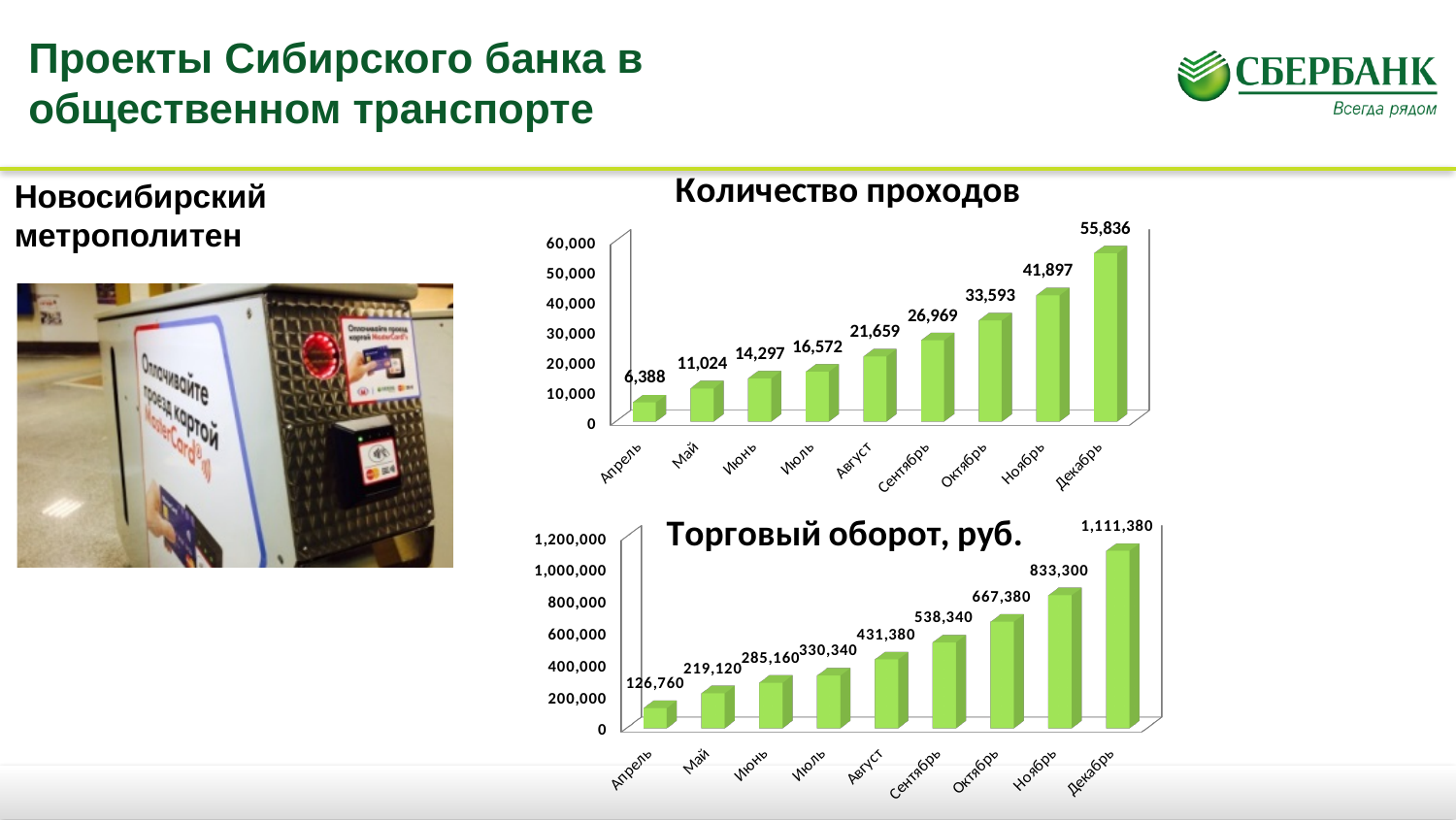
In the "Торговый оборот, руб." chart, what is the difference between the values for Ноябрь and Октябрь? 165,920 What kind of chart is the "Торговый оборот, руб." chart? bar chart In the "Торговый оборот, руб." chart, what is the value for Август? 431,380 In the "Торговый оборот, руб." chart, which is larger, the value for Июнь or the value for Июль? Июль What is the title of the top chart on the slide? Количество проходов In the "Количество проходов" chart, which month has the highest value? Декабрь In the "Количество проходов" chart, do the values rise or fall from Апрель to Декабрь? rise In the "Количество проходов" chart, what is the difference between the values for Декабрь and Ноябрь? 13,939 In the "Торговый оборот, руб." chart, what is the value for Декабрь? 1,111,380 In the "Количество проходов" chart, how many months are plotted? 9 In the "Количество проходов" chart, which month has the lowest value? Апрель In the "Количество проходов" chart, what is the value for Сентябрь? 26,969